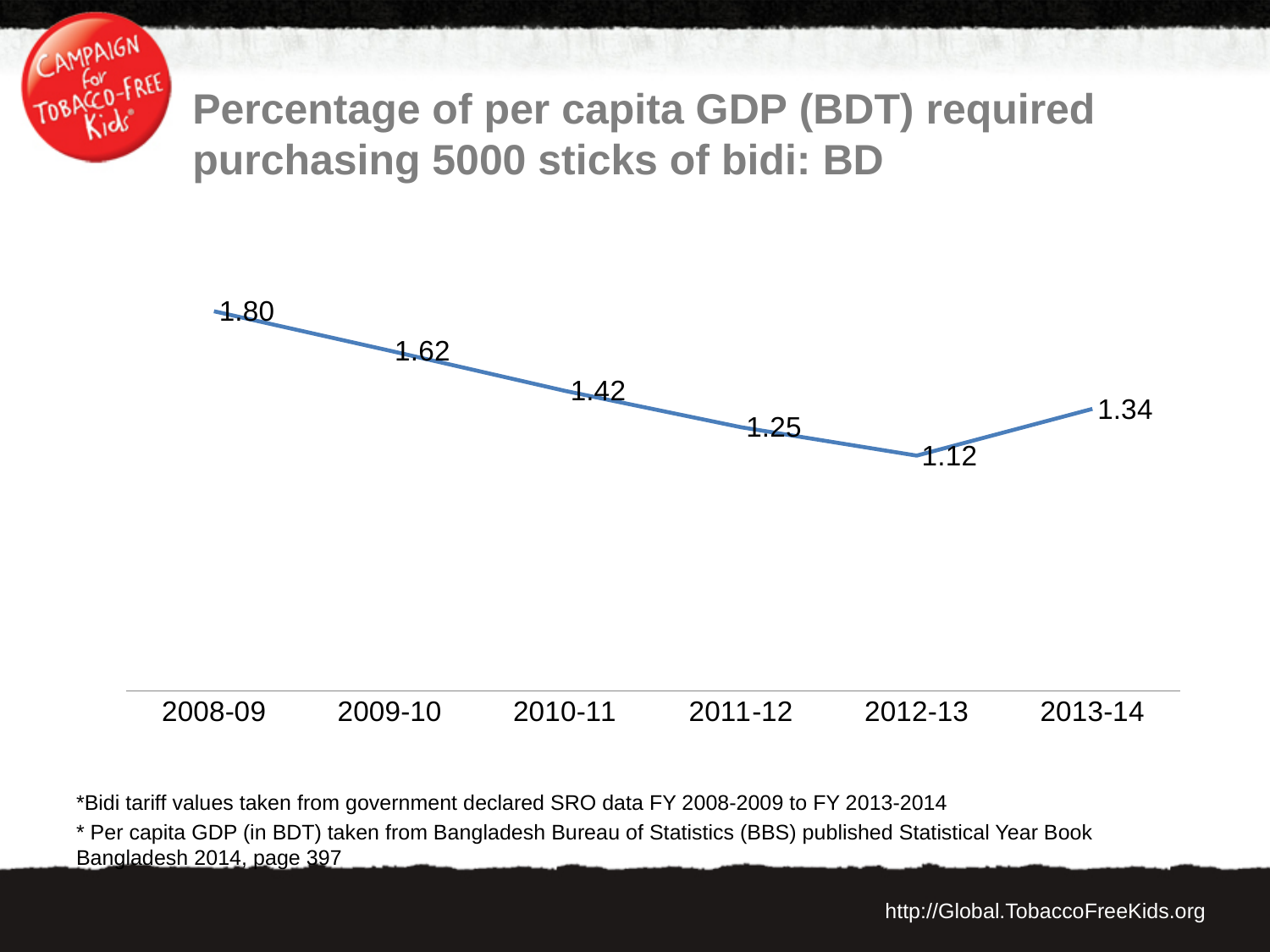
What is the difference between the values for 2009-10 and 2010-11? 0.20 What kind of chart is shown on the slide? line chart Do the values rise or fall from 2008-09 to 2012-13? fall What is the value for 2011-12? 1.25 Which is larger, the value for 2011-12 or the value for 2013-14? 2013-14 What is the value for 2008-09? 1.80 What is the difference between the values for 2008-09 and 2012-13? 0.68 What is the value for 2013-14? 1.34 How many years are plotted on the chart? 6 What is the title of the chart? Percentage of per capita GDP (BDT) required purchasing 5000 sticks of bidi: BD Which year has the lowest value? 2012-13 Which year has the highest value? 2008-09